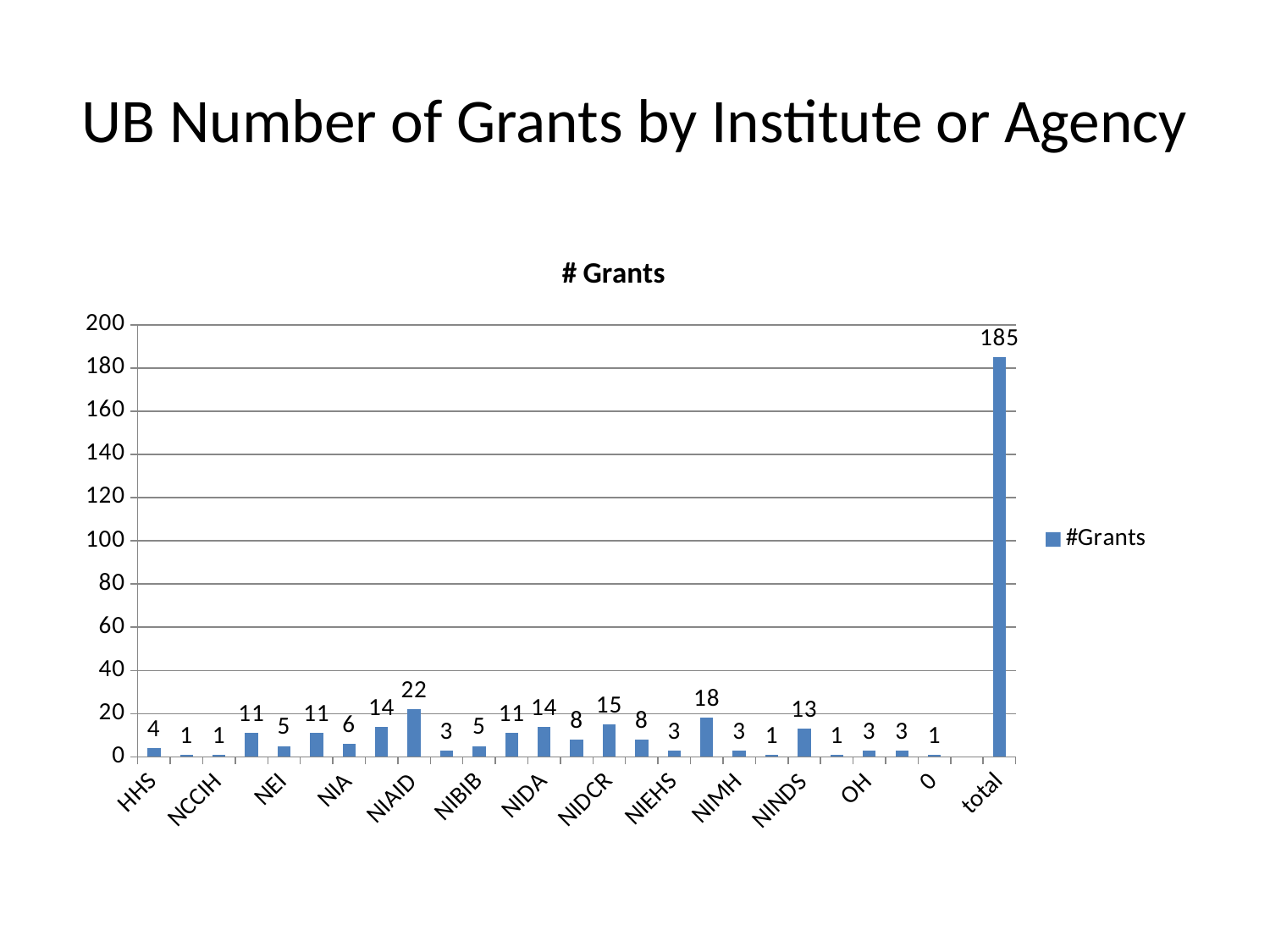
What is the value for NINDS? 13 Which category has the tallest bar? total How many series does the legend list? 1 What kind of chart is this? bar chart What is the value for total? 185 What is the value for NIAID? 22 Is the value for total greater or less than 180? greater What is the value for NIDCR? 15 What is the value for HHS? 4 What is the title of the chart? # Grants Which is larger, the value for NIDCR or the value for NIDA? NIDCR What is the difference between the value for total and the value for NIAID? 163